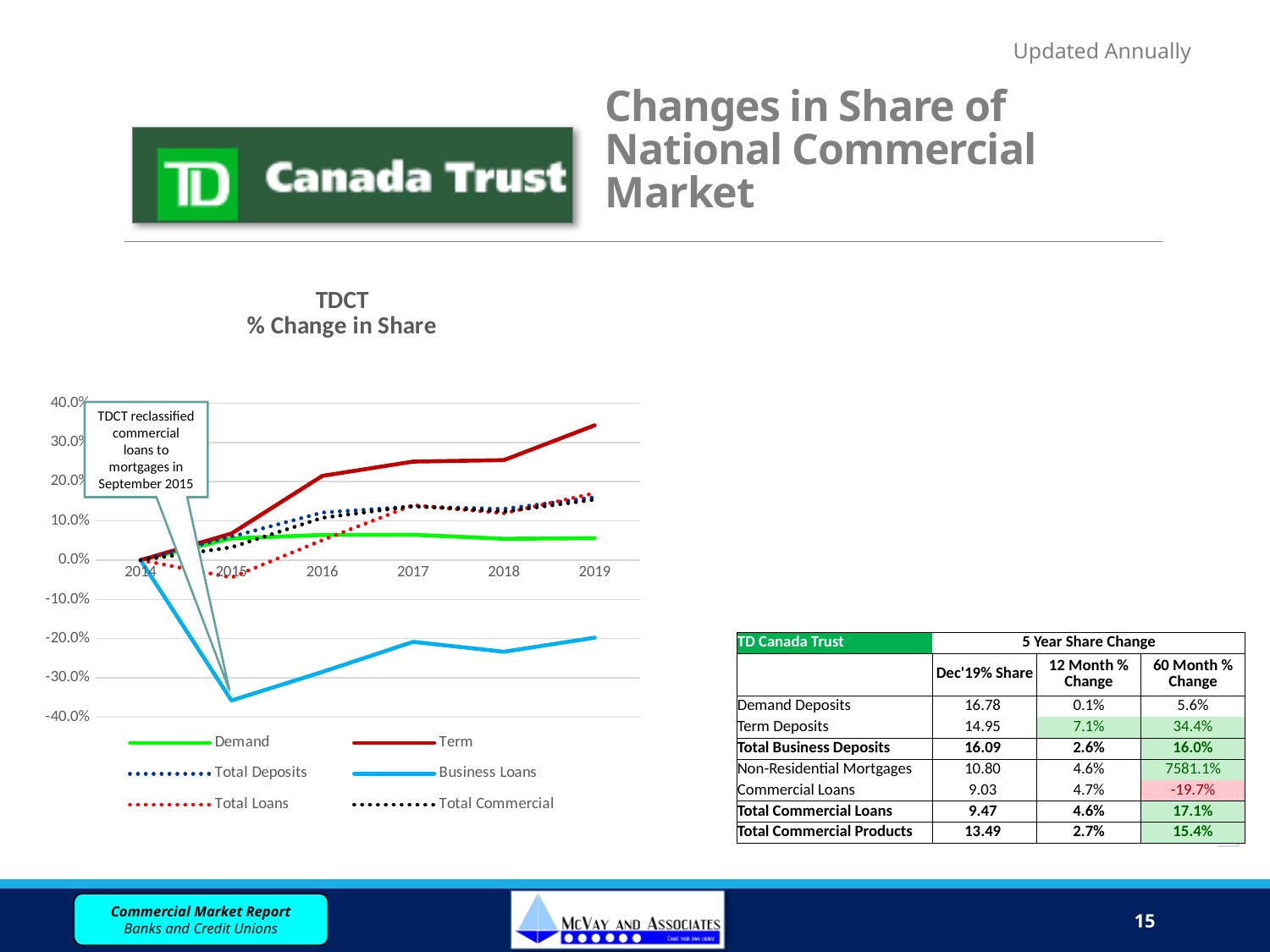
What kind of chart is the 'TDCT % Change in Share' chart? line chart Is the value for Business Loans in 2015 greater or less than -30.0%? less Is the value for Term in 2017 greater or less than 20.0%? greater What does the annotation box on the 'TDCT % Change in Share' chart say? TDCT reclassified commercial loans to mortgages in September 2015 Does the Term series rise or fall from 2014 to 2019 on the 'TDCT % Change in Share' chart? rise Which is larger in 2018 on the 'TDCT % Change in Share' chart, Demand or Business Loans? Demand How many years are shown on the x axis of the 'TDCT % Change in Share' chart? 6 Which series has the highest value in 2019 on the 'TDCT % Change in Share' chart? Term Is the value for Demand in 2019 greater or less than 10.0%? less How many series does the legend of the 'TDCT % Change in Share' chart list? 6 Which series has the lowest value in 2015 on the 'TDCT % Change in Share' chart? Business Loans